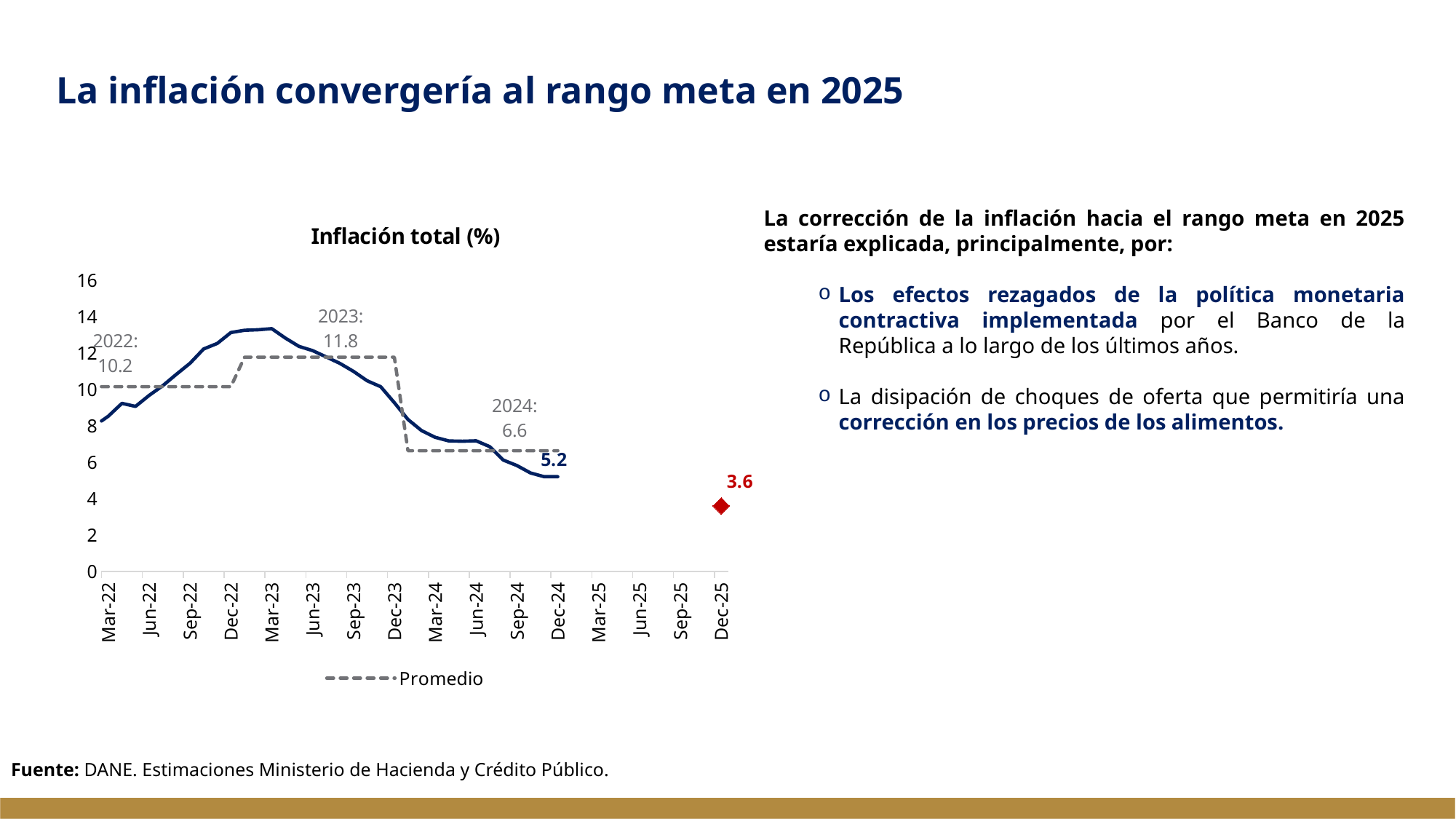
Which year has the highest average (Promedio) inflation shown on the chart? 2023 What value is labelled at the red diamond point at Dec-25? 3.6 Does the solid inflation line rise or fall between Mar-23 and Dec-24? fall Is the inflation value at Mar-23 greater or less than 12? greater Which year has the lowest average (Promedio) inflation shown on the chart? 2024 What is the difference between the 2023 average (11.8) and the 2024 average (6.6)? 5.2 What is the average (Promedio) inflation shown for 2023? 11.8 What series name appears in the chart legend? Promedio What kind of chart is shown under the title "Inflación total (%)"? line chart Which is larger, the value at Dec-24 or the value at Dec-25? Dec-24 What is the inflation value labelled at Dec-24 on the chart? 5.2 What is the average (Promedio) inflation shown for 2022? 10.2